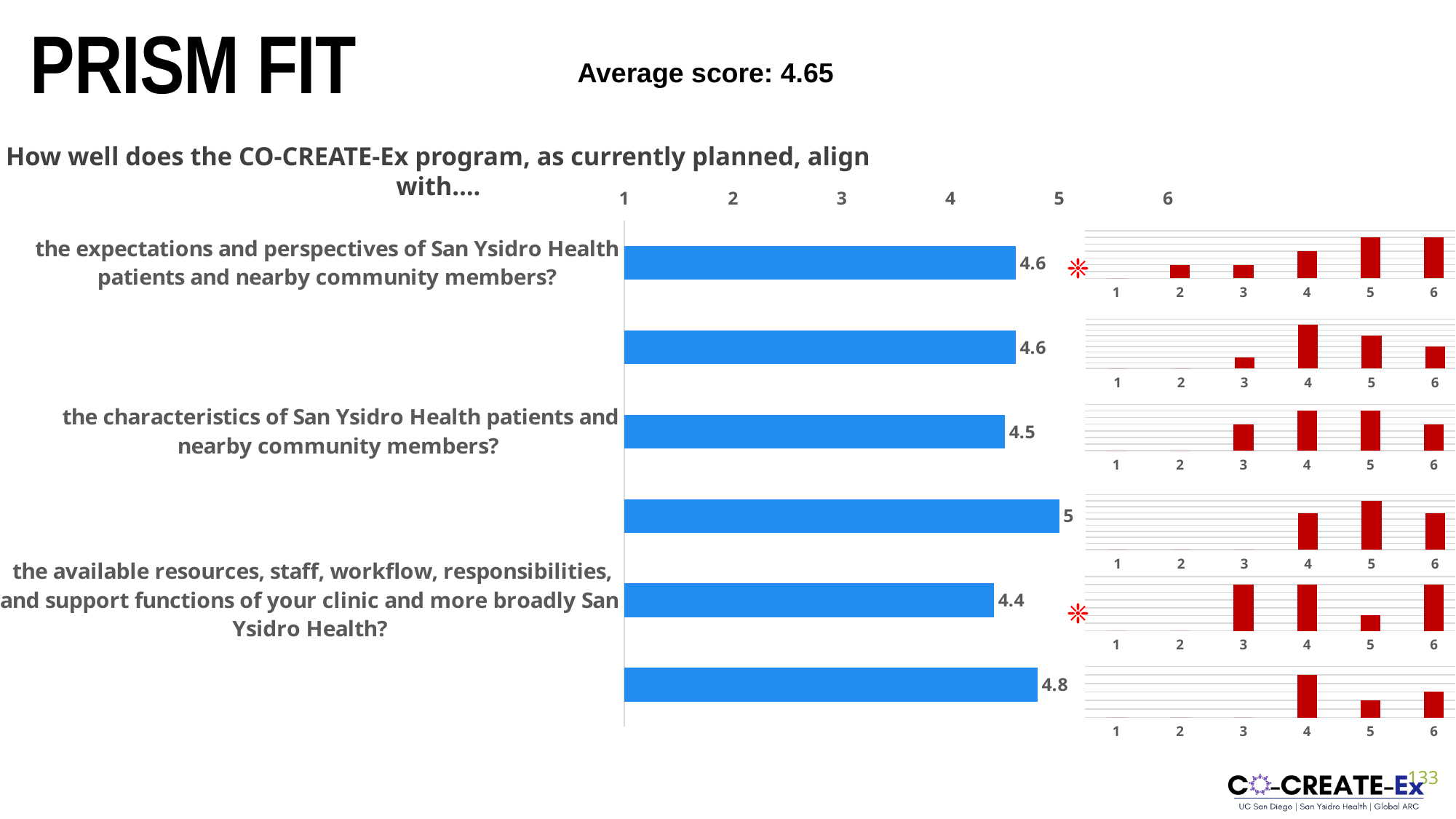
What is the lowest value shown on any bar in the blue bar chart? 4.4 What average score is stated at the top of the slide? 4.65 What is the value for 'the expectations and perspectives of San Ysidro Health patients and nearby community members?' in the blue bar chart? 4.6 Which labelled category has the lowest value in the blue bar chart? the available resources, staff, workflow, responsibilities, and support functions of your clinic and more broadly San Ysidro Health? Is the value for 'the characteristics of San Ysidro Health patients and nearby community members?' greater or less than 4? greater What is the value for 'the available resources, staff, workflow, responsibilities, and support functions of your clinic and more broadly San Ysidro Health?' in the blue bar chart? 4.4 What is the difference between the value for 'the expectations and perspectives of San Ysidro Health patients and nearby community members?' and the value for 'the characteristics of San Ysidro Health patients and nearby community members?'? 0.1 How many bars are in the blue bar chart? 6 What is the highest value shown on any bar in the blue bar chart? 5 What kind of chart is the blue chart in the middle of the slide? bar chart What is the value for 'the characteristics of San Ysidro Health patients and nearby community members?' in the blue bar chart? 4.5 Which is larger in the blue bar chart: the value for 'the expectations and perspectives of San Ysidro Health patients and nearby community members?' or the value for 'the available resources, staff, workflow, responsibilities, and support functions of your clinic and more broadly San Ysidro Health?'? the expectations and perspectives of San Ysidro Health patients and nearby community members?